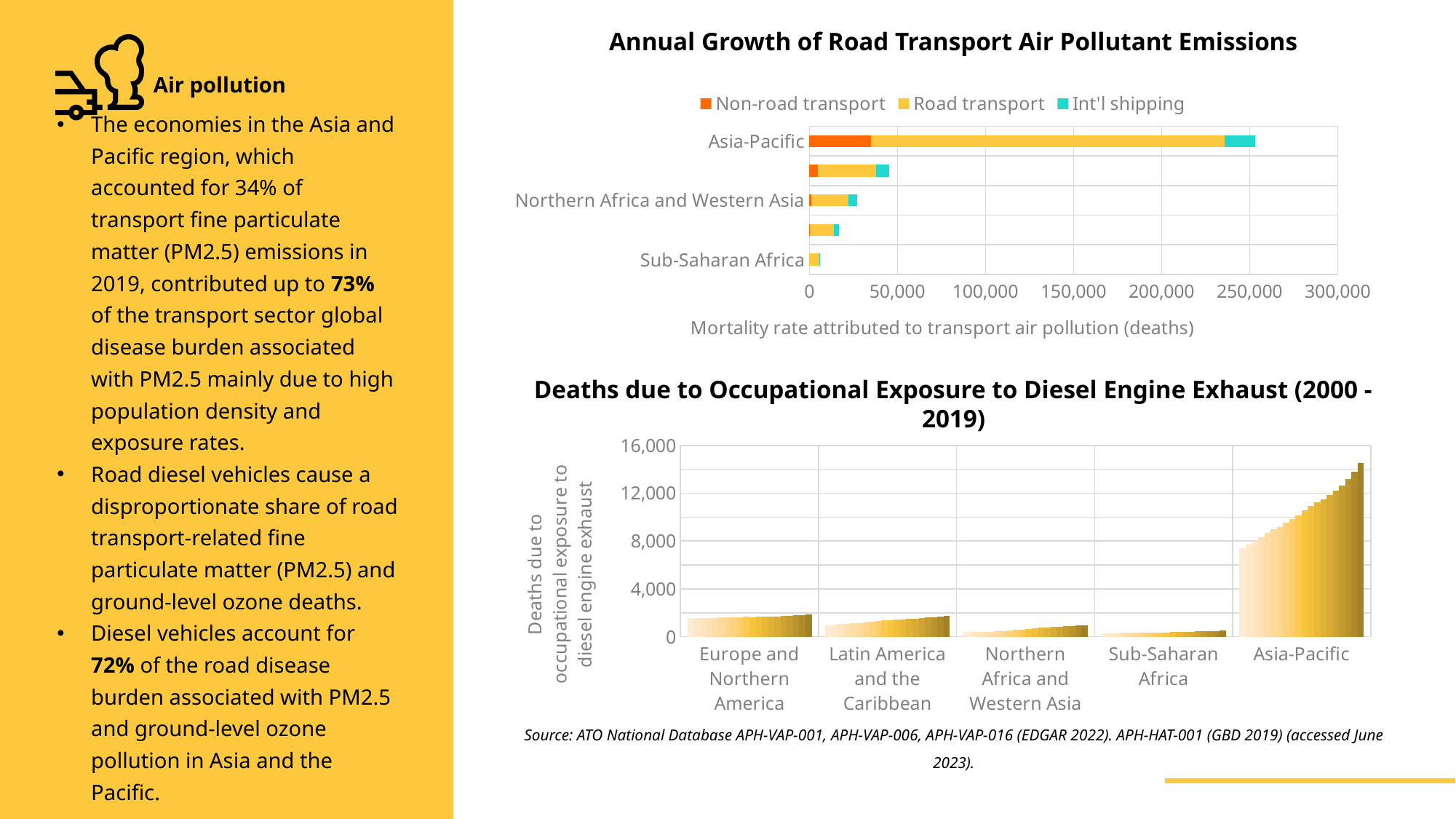
In the 'Deaths due to Occupational Exposure to Diesel Engine Exhaust (2000 - 2019)' chart, which region has the lowest values? Sub-Saharan Africa How many series does the legend of the 'Annual Growth of Road Transport Air Pollutant Emissions' chart list? 3 What kind of chart is the 'Annual Growth of Road Transport Air Pollutant Emissions' chart? Bar chart In the 'Annual Growth of Road Transport Air Pollutant Emissions' chart, is the total value for Sub-Saharan Africa greater or less than 50,000? less How many regions are shown on the x axis of the 'Deaths due to Occupational Exposure to Diesel Engine Exhaust (2000 - 2019)' chart? 5 In the 'Annual Growth of Road Transport Air Pollutant Emissions' chart, which has the larger total bar: Asia-Pacific or Northern Africa and Western Asia? Asia-Pacific In the 'Annual Growth of Road Transport Air Pollutant Emissions' chart, which series are listed in the legend? Non-road transport, Road transport, Int'l shipping In the 'Deaths due to Occupational Exposure to Diesel Engine Exhaust (2000 - 2019)' chart, do the bars for Asia-Pacific rise or fall from 2000 to 2019? Rise In the 'Annual Growth of Road Transport Air Pollutant Emissions' chart, which labelled region has the longest total bar? Asia-Pacific In the 'Deaths due to Occupational Exposure to Diesel Engine Exhaust (2000 - 2019)' chart, which region has the highest values? Asia-Pacific In the 'Annual Growth of Road Transport Air Pollutant Emissions' chart, which labelled region has the shortest total bar? Sub-Saharan Africa In the 'Annual Growth of Road Transport Air Pollutant Emissions' chart, is the total value for Asia-Pacific greater or less than 200,000? greater